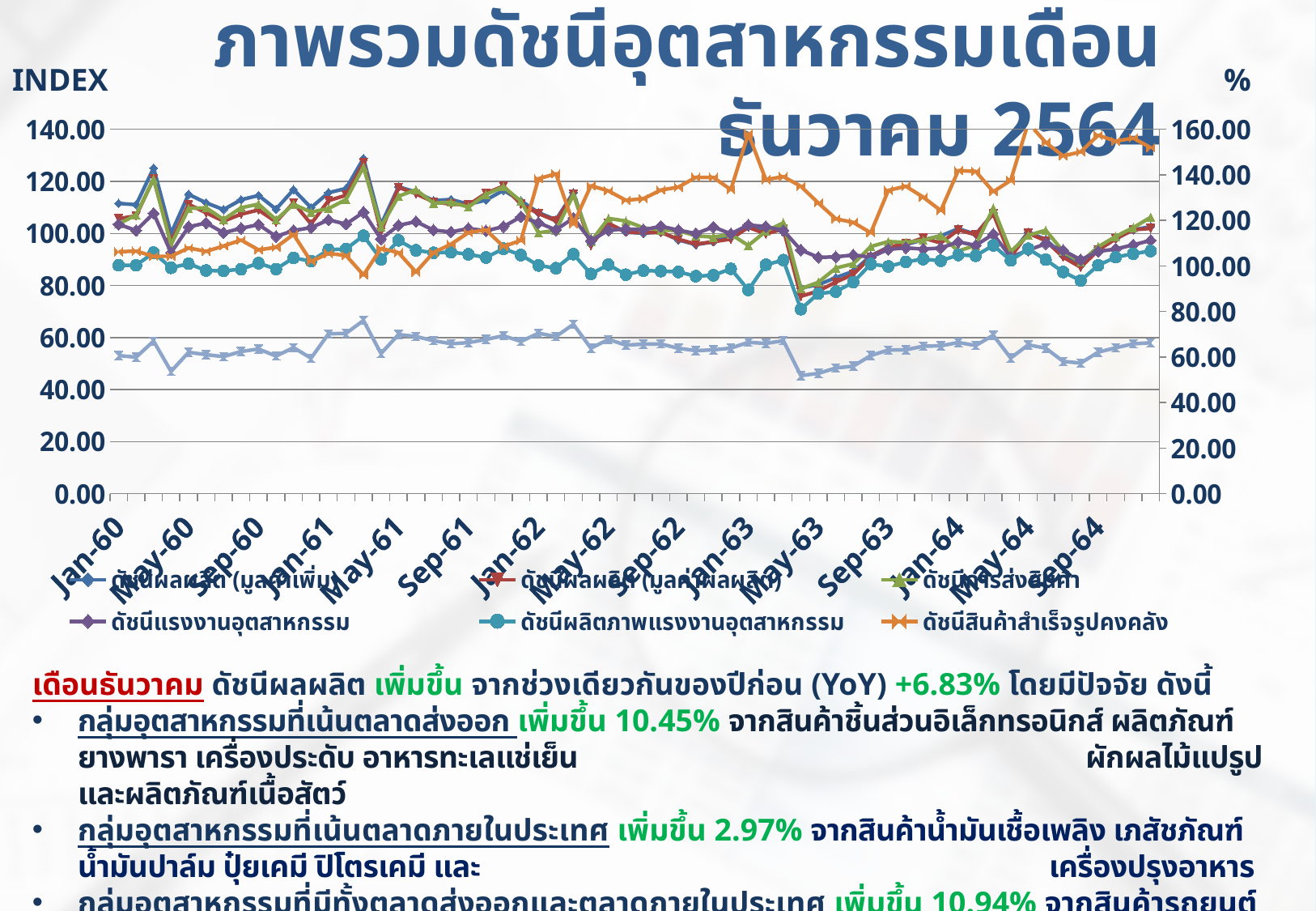
What is the title of the chart? ภาพรวมดัชนีอุตสาหกรรมเดือนธันวาคม 2564 How many series does the chart legend list? 6 What is the first category label on the x axis? Jan-60 How many category labels are printed along the x axis? 15 What is the last category label shown on the x axis? Sep-64 Is the value for ดัชนีแรงงานอุตสาหกรรม at Jan-60 greater or less than 80? greater What is the highest tick value shown on the right vertical axis? 160.00 Is the value for ดัชนีผลิตภาพแรงงานอุตสาหกรรม at Jan-60 greater or less than 60? greater What label is shown on the left vertical axis of the chart? INDEX What kind of chart is shown on the slide? line chart What is the highest tick value shown on the left vertical axis? 140.00 Between May-63 and Sep-63, does the ดัชนีผลิตภาพแรงงานอุตสาหกรรม line rise or fall? rise